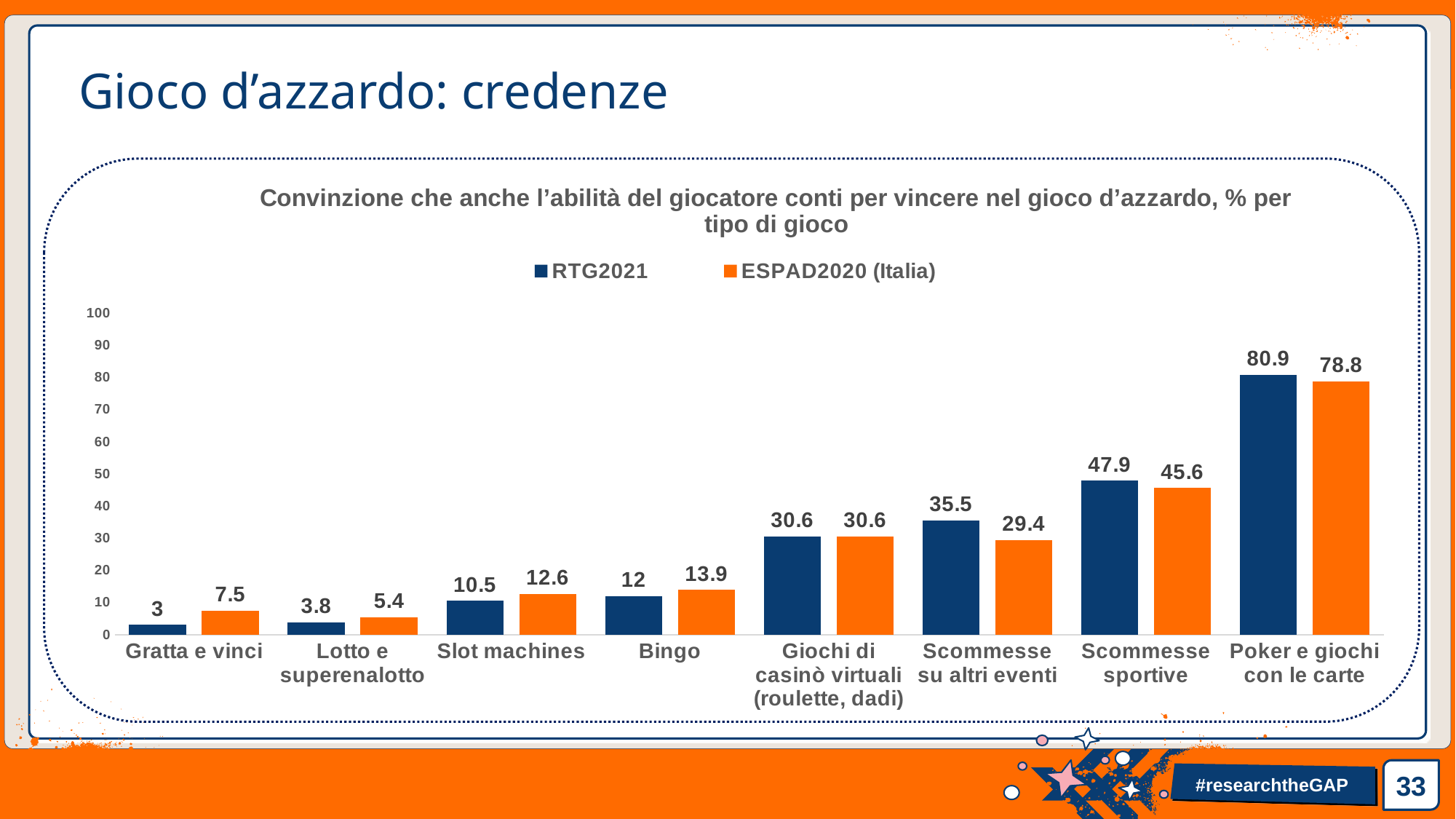
Which category has the lowest ESPAD2020 (Italia) value? Lotto e superenalotto What is the difference between the RTG2021 and ESPAD2020 (Italia) values for Scommesse su altri eventi? 6.1 How many game categories are shown on the x axis? 8 What is the RTG2021 value for Scommesse sportive? 47.9 How many series does the legend list? 2 Is the ESPAD2020 (Italia) value for Scommesse sportive greater or less than 50? less What is the ESPAD2020 (Italia) value for Bingo? 13.9 What is the RTG2021 value for Slot machines? 10.5 What kind of chart is shown on the slide? bar chart Which category has the highest RTG2021 value? Poker e giochi con le carte Which colour represents the ESPAD2020 (Italia) series? orange For Gratta e vinci, which series has the larger value, RTG2021 or ESPAD2020 (Italia)? ESPAD2020 (Italia)